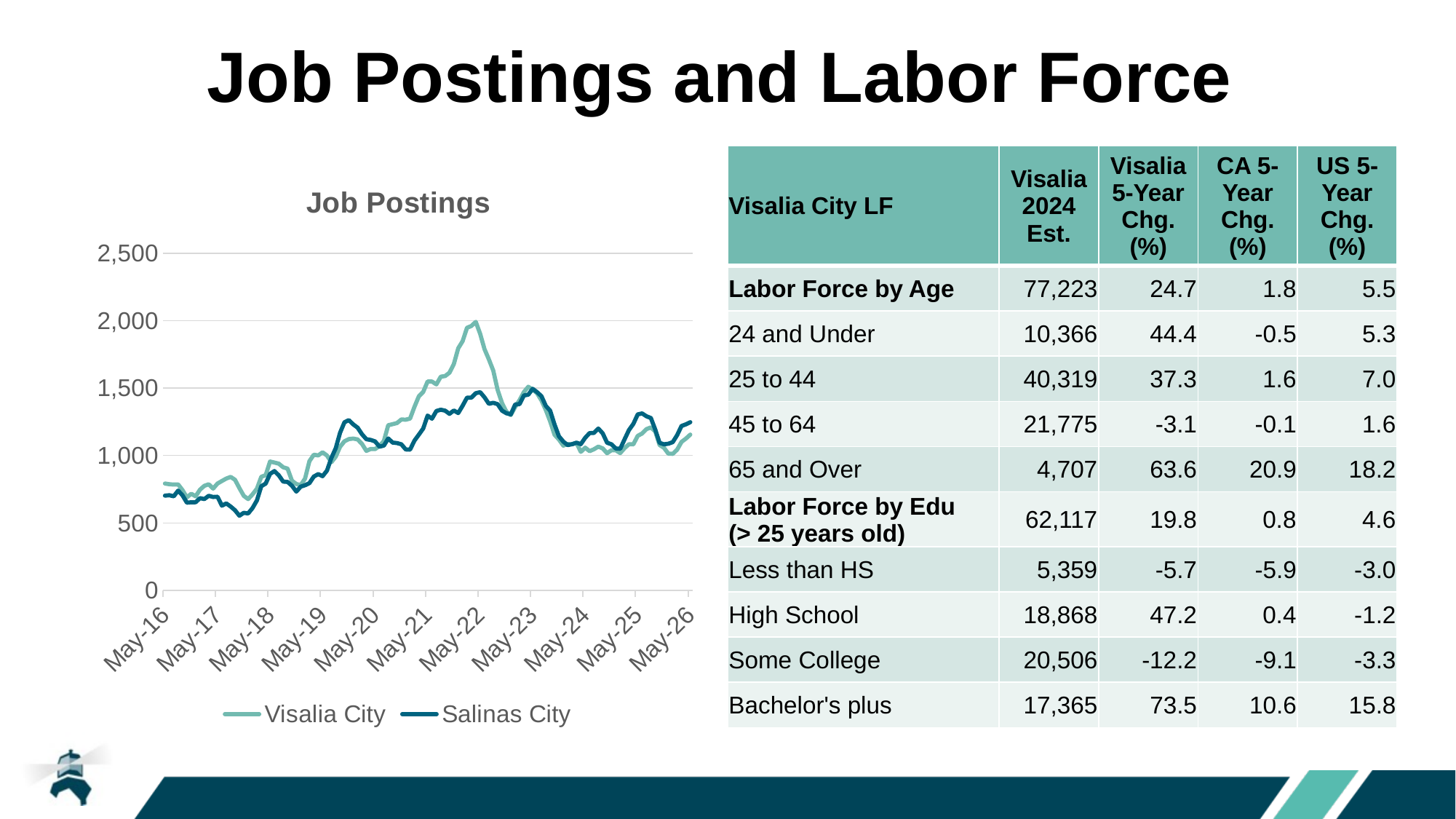
What kind of chart is the Job Postings chart? line chart Which two series are shown in the Job Postings chart? Visalia City and Salinas City Is the peak value for Visalia City in the Job Postings chart greater or less than 1,500? greater How many series does the legend of the Job Postings chart list? 2 Which series reaches the lowest value in the Job Postings chart? Salinas City Do Visalia City job postings rise or fall between May-16 and May-22? rise What is the title of the chart on the slide? Job Postings Around May-22, which series is higher in the Job Postings chart, Visalia City or Salinas City? Visalia City Is the value for Salinas City at May-16 in the Job Postings chart greater or less than 1,000? less Is the peak value for Salinas City in the Job Postings chart greater or less than 2,000? less Which series reaches the highest value in the Job Postings chart? Visalia City How many date labels are shown on the x axis of the Job Postings chart? 11